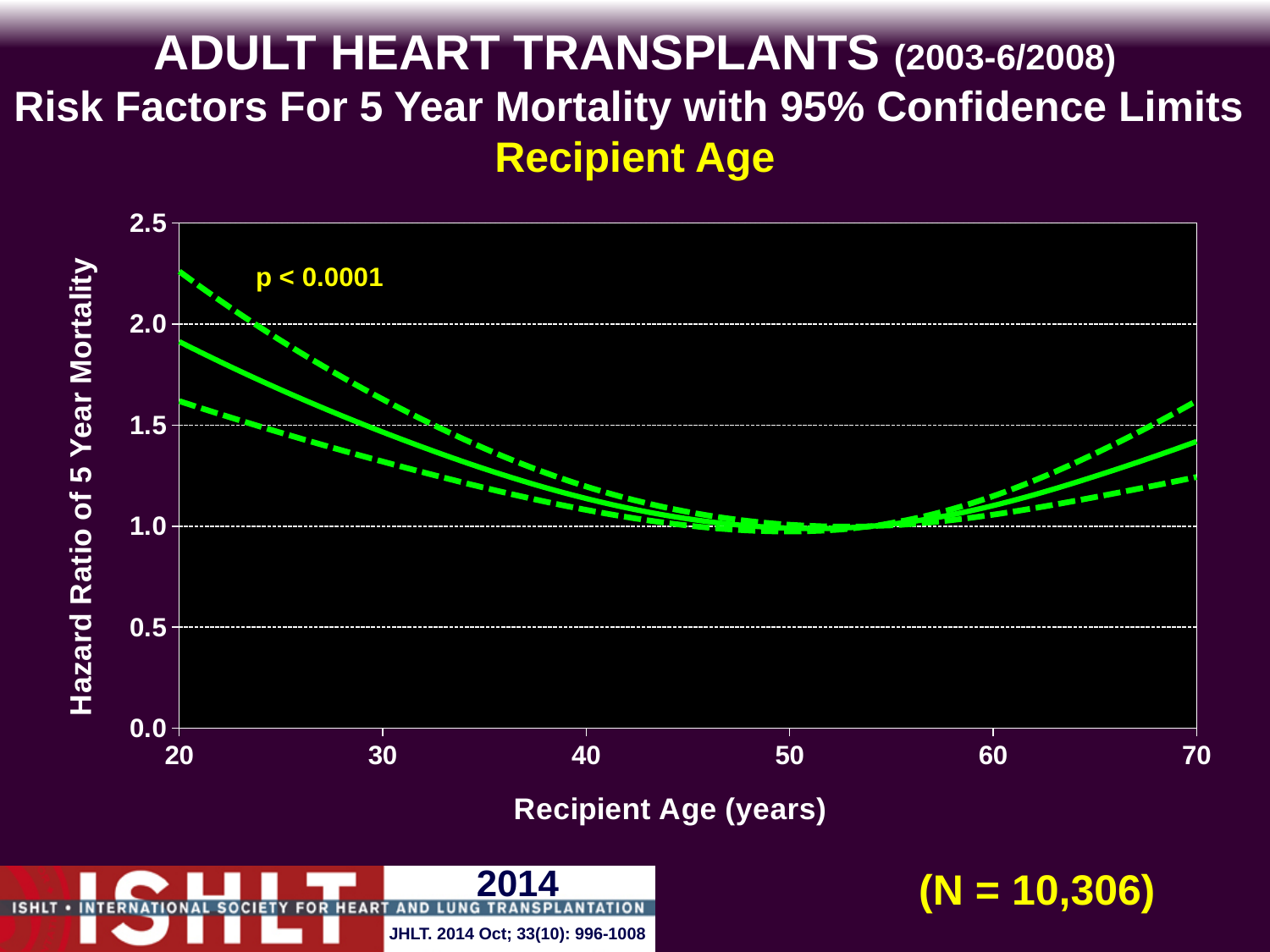
What is the label of the y axis? Hazard Ratio of 5 Year Mortality How many lines are plotted on the chart? 3 What kind of chart is shown on the slide? line chart Is the value of the solid hazard ratio line at recipient age 20 greater or less than 1.5? greater Is the solid hazard ratio line higher at recipient age 30 or at recipient age 50? 30 What is the label of the x axis? Recipient Age (years) Is the solid hazard ratio line higher at recipient age 20 or at recipient age 70? 20 Is the upper confidence limit (upper dashed line) at recipient age 20 greater or less than 2.0? greater Is the value of the solid hazard ratio line at recipient age 70 greater or less than 1.0? greater Does the solid hazard ratio line rise or fall as recipient age increases from 50 to 70 years? rise Does the solid hazard ratio line rise or fall as recipient age increases from 20 to 50 years? fall